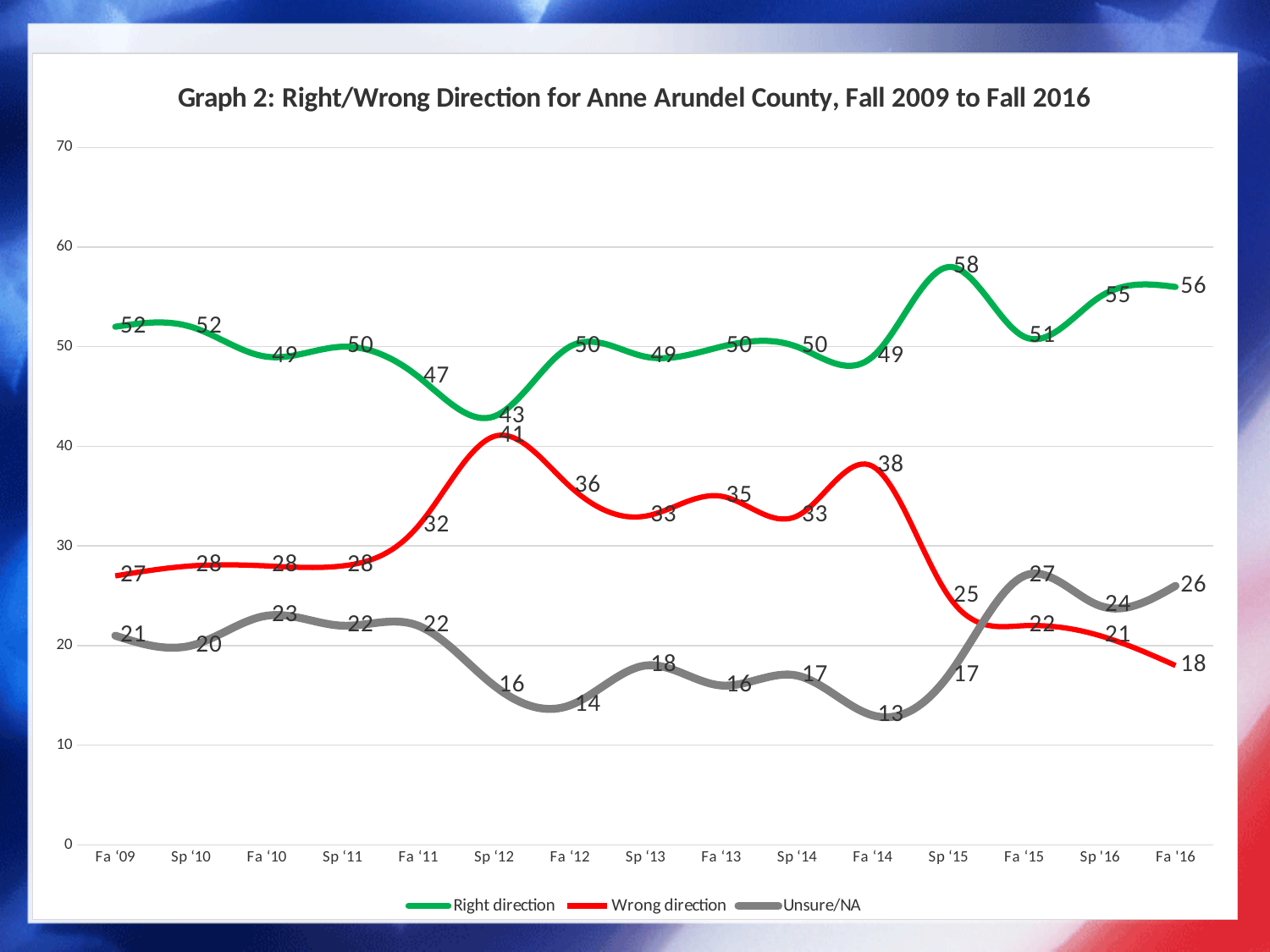
In which period does the Wrong direction series reach its highest value? Sp '12 In which period does the Unsure/NA series reach its lowest value? Fa '14 Does the Wrong direction series rise or fall from Fa '14 to Fa '16? Fall How many series does the legend list? 3 In Fa '15, which is larger: Wrong direction or Unsure/NA? Unsure/NA What kind of chart is shown on the slide? Line chart In which period does the Right direction series reach its lowest value? Sp '12 What is the Right direction value for Sp '15? 58 How many survey periods are plotted along the x axis? 15 What is the Unsure/NA value for Fa '12? 14 What is the difference between the Right direction and Wrong direction values in Fa '16? 38 In which period does the Right direction series reach its highest value? Sp '15